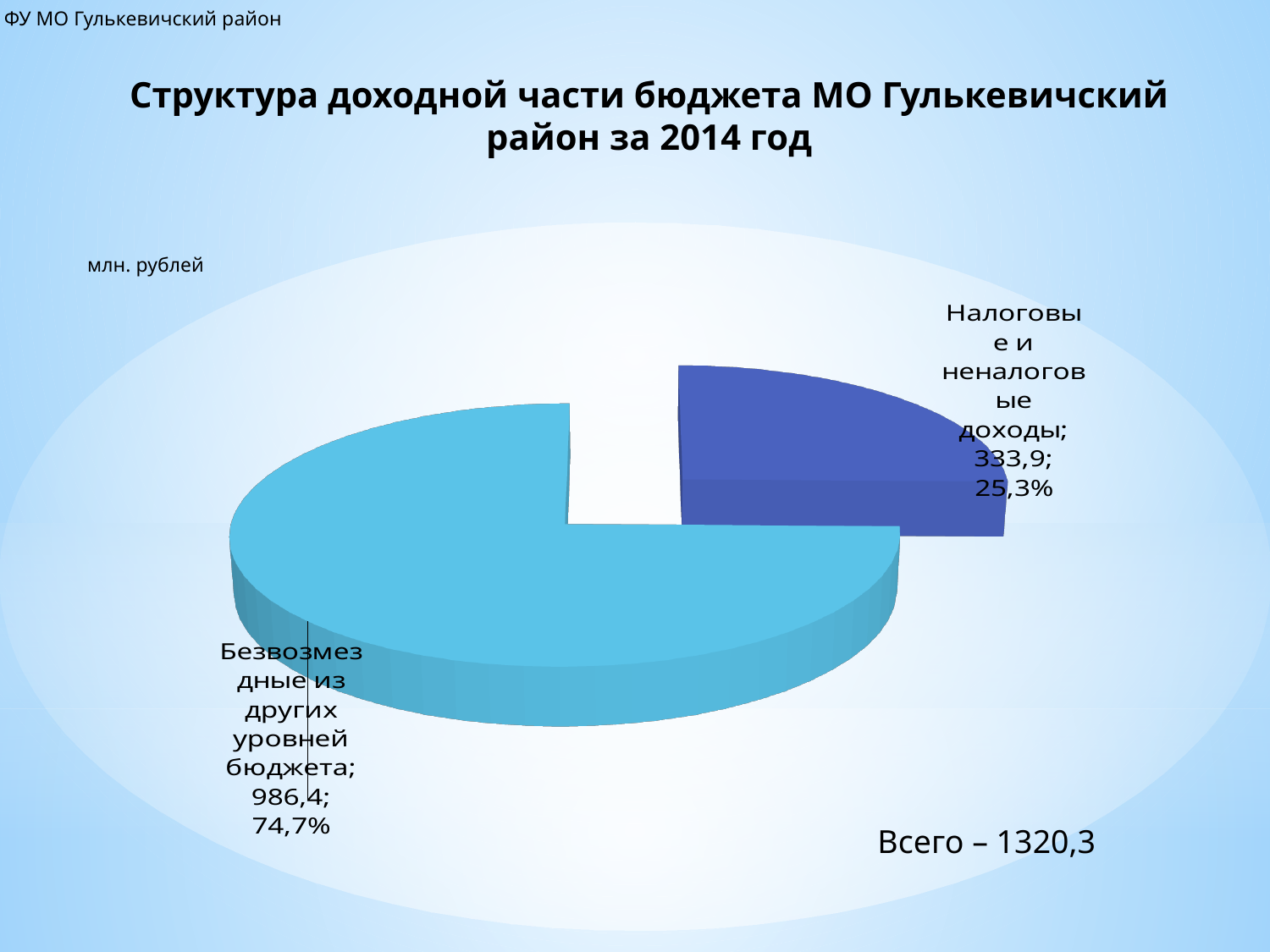
What is the value for "Безвозмездные из других уровней бюджета"? 986,4 What total (Всего) is shown on the slide for the pie chart? 1320,3 What is the difference between the values for "Безвозмездные из других уровней бюджета" and "Налоговые и неналоговые доходы"? 652,5 What share of the pie does "Налоговые и неналоговые доходы" represent? 25,3% What unit of measurement is indicated for the chart values? млн. рублей How many slices does the pie chart have? 2 Which category has the largest slice of the pie? Безвозмездные из других уровней бюджета What is the value for "Налоговые и неналоговые доходы"? 333,9 Which category has the smallest slice of the pie? Налоговые и неналоговые доходы What share of the pie does "Безвозмездные из других уровней бюджета" represent? 74,7% What kind of chart is shown on the slide? Pie chart Which is larger: "Безвозмездные из других уровней бюджета" or "Налоговые и неналоговые доходы"? Безвозмездные из других уровней бюджета